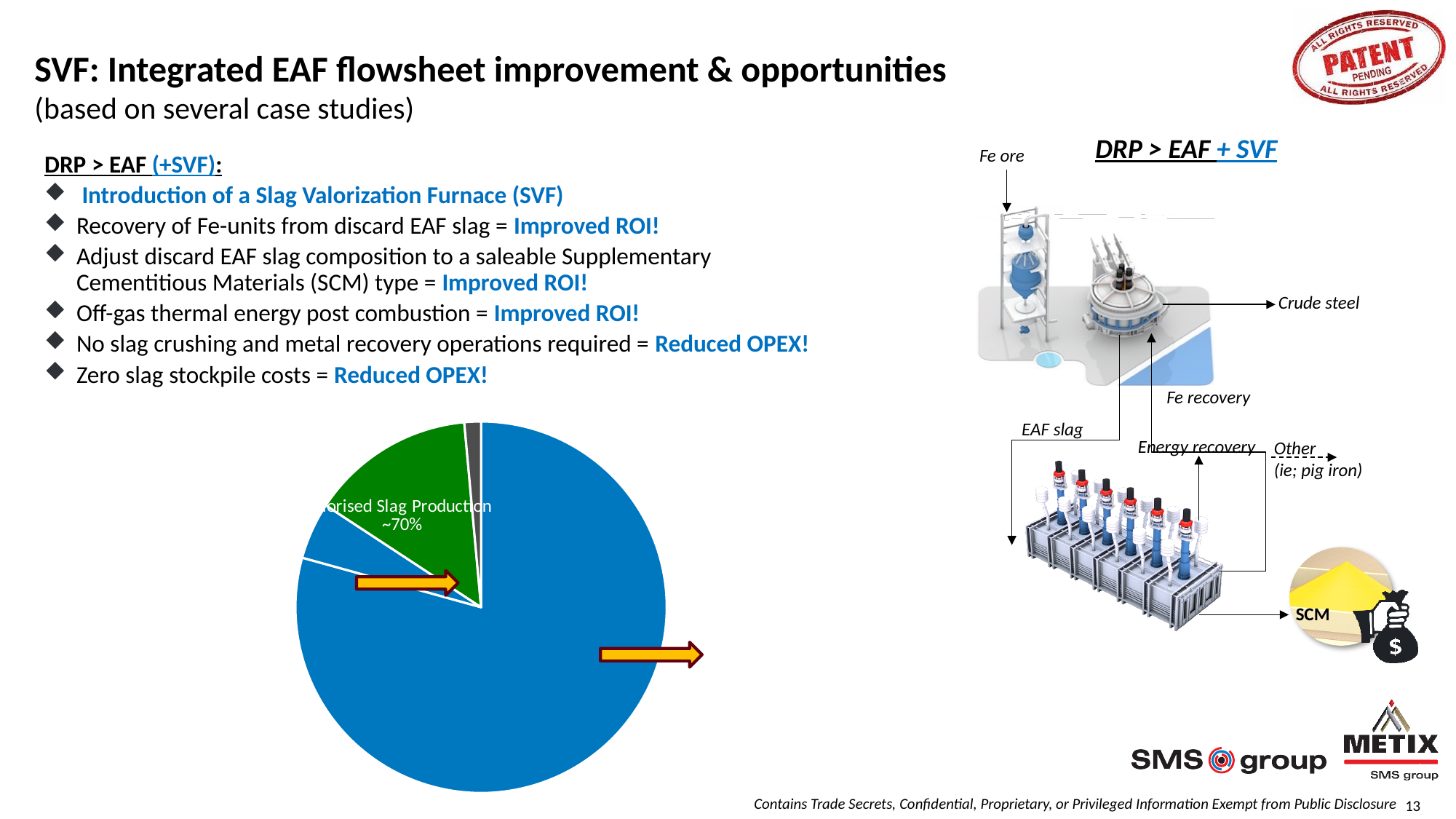
Which colour slice is the smallest in the pie chart? grey Which colour slice is the largest in the pie chart? blue In the pie chart, which is larger, the large blue slice or the green slice? the large blue slice Does the pie chart have a legend? No How many slices does the pie chart have? 4 In the pie chart, which is larger, the green slice or the grey slice? green What kind of chart is shown on the slide? pie chart